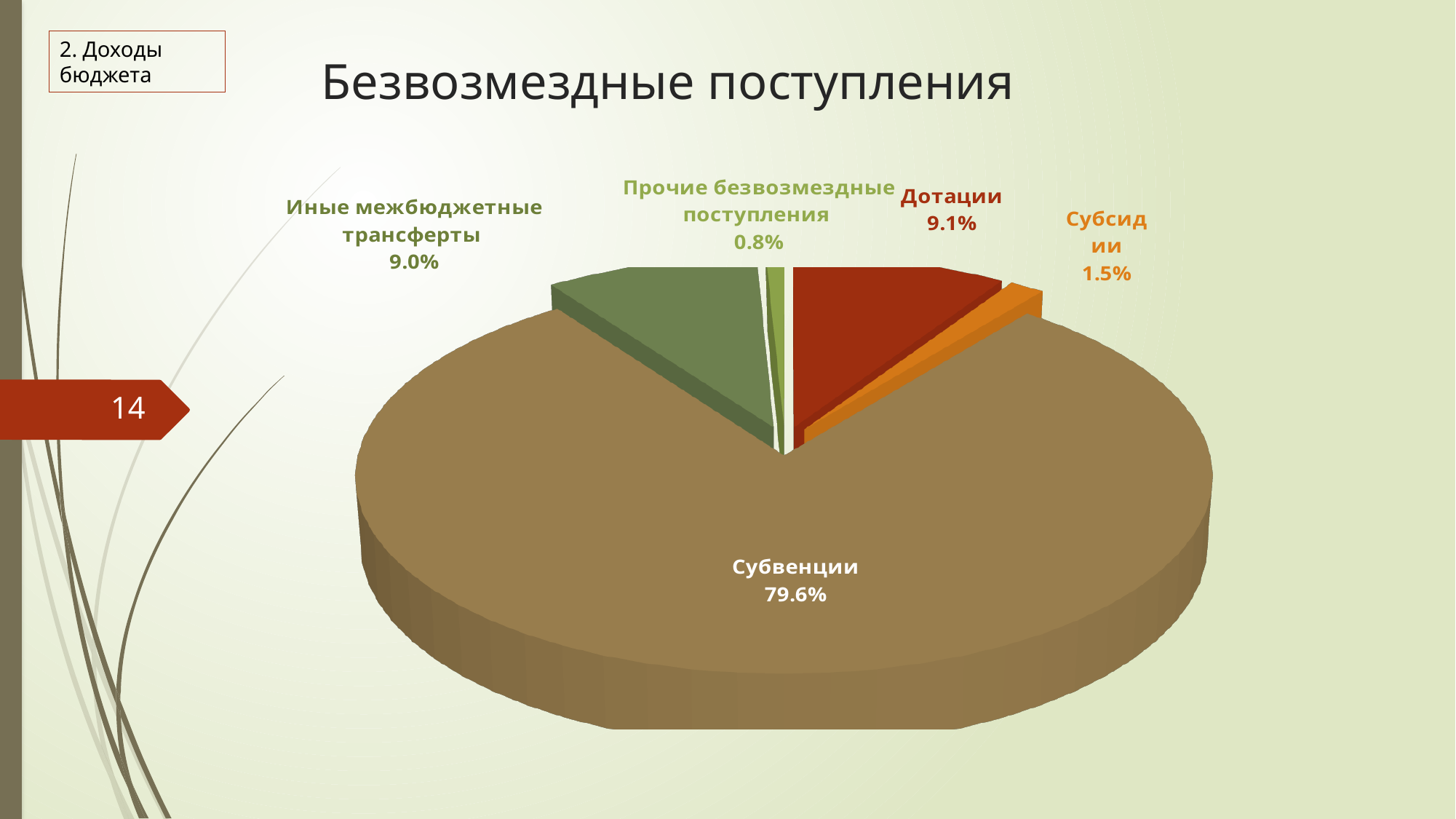
How many slices does the pie chart have? 5 What is the share of Субсидии in the pie chart? 1.5% What is the share of Прочие безвозмездные поступления in the pie chart? 0.8% Which category has the largest share of the pie chart? Субвенции What kind of chart is shown on the slide? Pie chart What is the difference in percentage points between Субвенции and Дотации? 70.5 Which is larger, the share of Субсидии or the share of Прочие безвозмездные поступления? Субсидии What is the share of Субвенции in the pie chart? 79.6% What is the share of Иные межбюджетные трансферты in the pie chart? 9.0% What is the title of the chart on the slide? Безвозмездные поступления Which category has the smallest share of the pie chart? Прочие безвозмездные поступления What is the share of Дотации in the pie chart? 9.1%